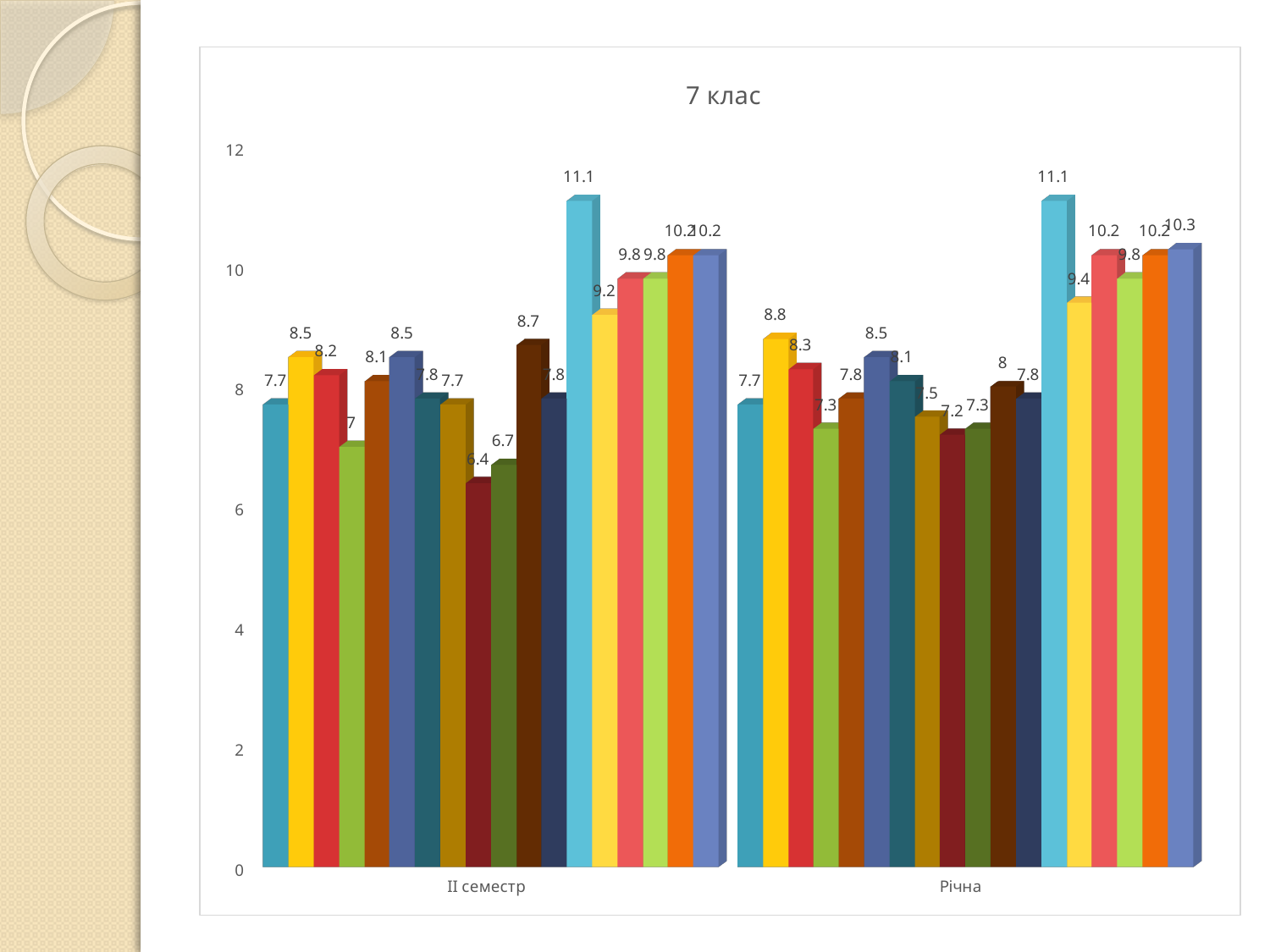
What is the highest value in the ІІ семестр group? 11.1 What is the lowest value in the Річна group? 7.2 What is the lowest value in the ІІ семестр group? 6.4 How many categories are shown on the x axis? 2 What is the value of the first (leftmost) bar in the Річна group? 7.7 What is the title of the chart? 7 клас Which is larger: the yellow bar in ІІ семестр (8.5) or the yellow bar in Річна (8.8)? Річна How many bars are plotted in the ІІ семестр group? 18 What is the difference between the highest and lowest values in the ІІ семестр group? 4.7 What is the value of the last (rightmost) bar in the Річна group? 10.3 What kind of chart is shown on the slide? bar chart Is the value of the first (leftmost) bar in the ІІ семестр group greater or less than 8? less